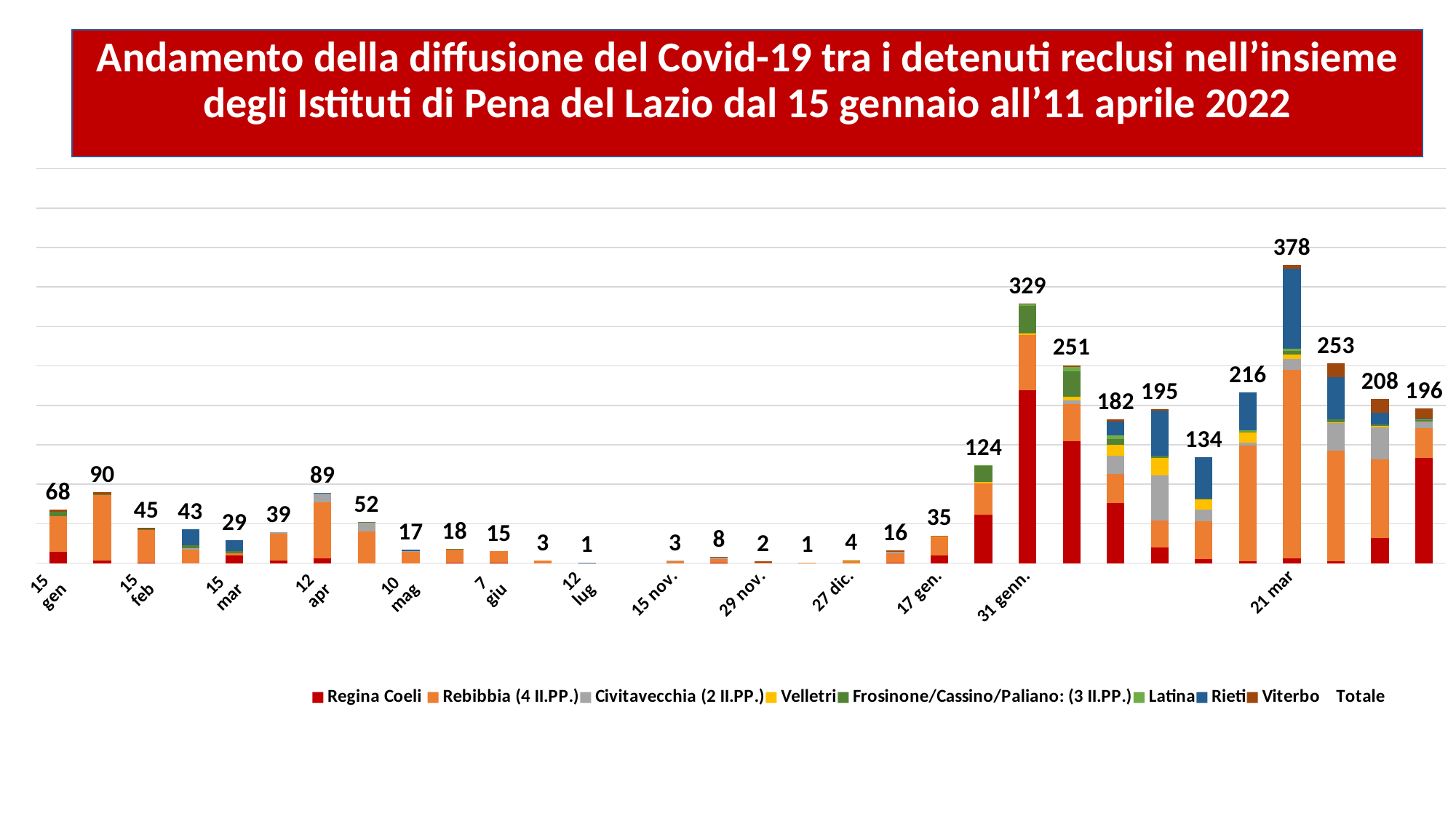
Which is larger, the total for 15 gen or the total for 17 gen.? 15 gen Which date has the highest total? 21 mar Which series makes up the largest part of the 21 mar bar? Rebibbia (4 II.PP.) What colour represents Rieti in the chart? Blue What is the total value of the bar labelled 31 genn.? 329 What kind of chart is shown on the slide? Stacked bar chart Do the totals rise or fall from 15 gen to 12 lug? Fall What is the total value of the bar labelled 21 mar? 378 How many entries does the legend list? 9 What is the difference between the totals for 21 mar and 31 genn.? 49 What is the total value of the bar labelled 12 apr? 89 What is the total value of the first bar, labelled 15 gen? 68